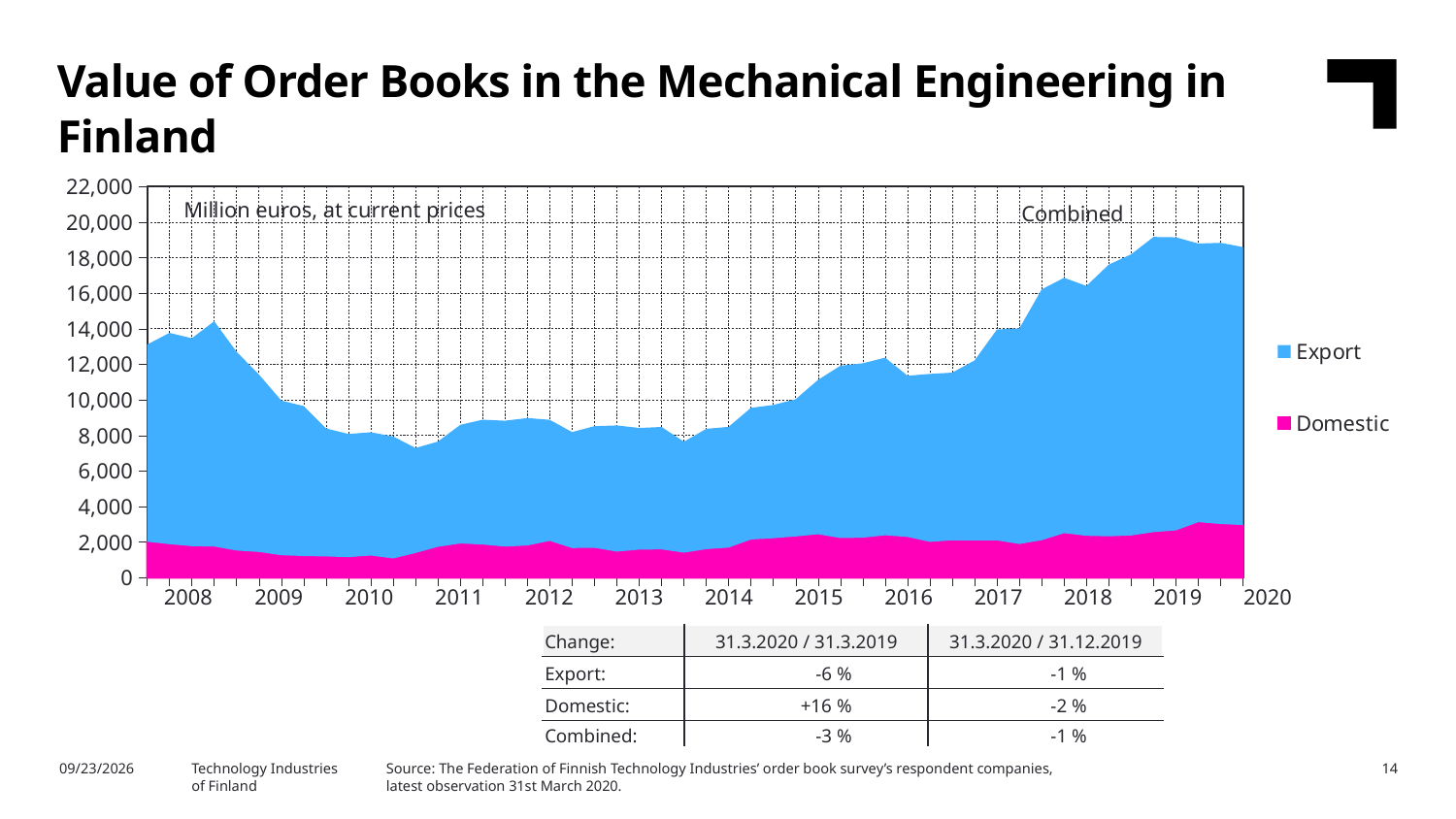
How many series does the legend list? 2 Does the combined value rise or fall from 2008 to 2010? fall Which is larger, the combined value in 2019 or in 2011? 2019 What kind of chart is shown on the slide? stacked area chart Is the combined value at the start of 2019 greater or less than 18,000? greater Is the combined value in 2014 greater or less than 6,000? greater Which series is shown in blue? Export Is the Domestic value in 2019 greater or less than 4,000? less What unit is stated for the values in the chart? Million euros, at current prices Does the combined value rise or fall from 2016 to 2019? rise